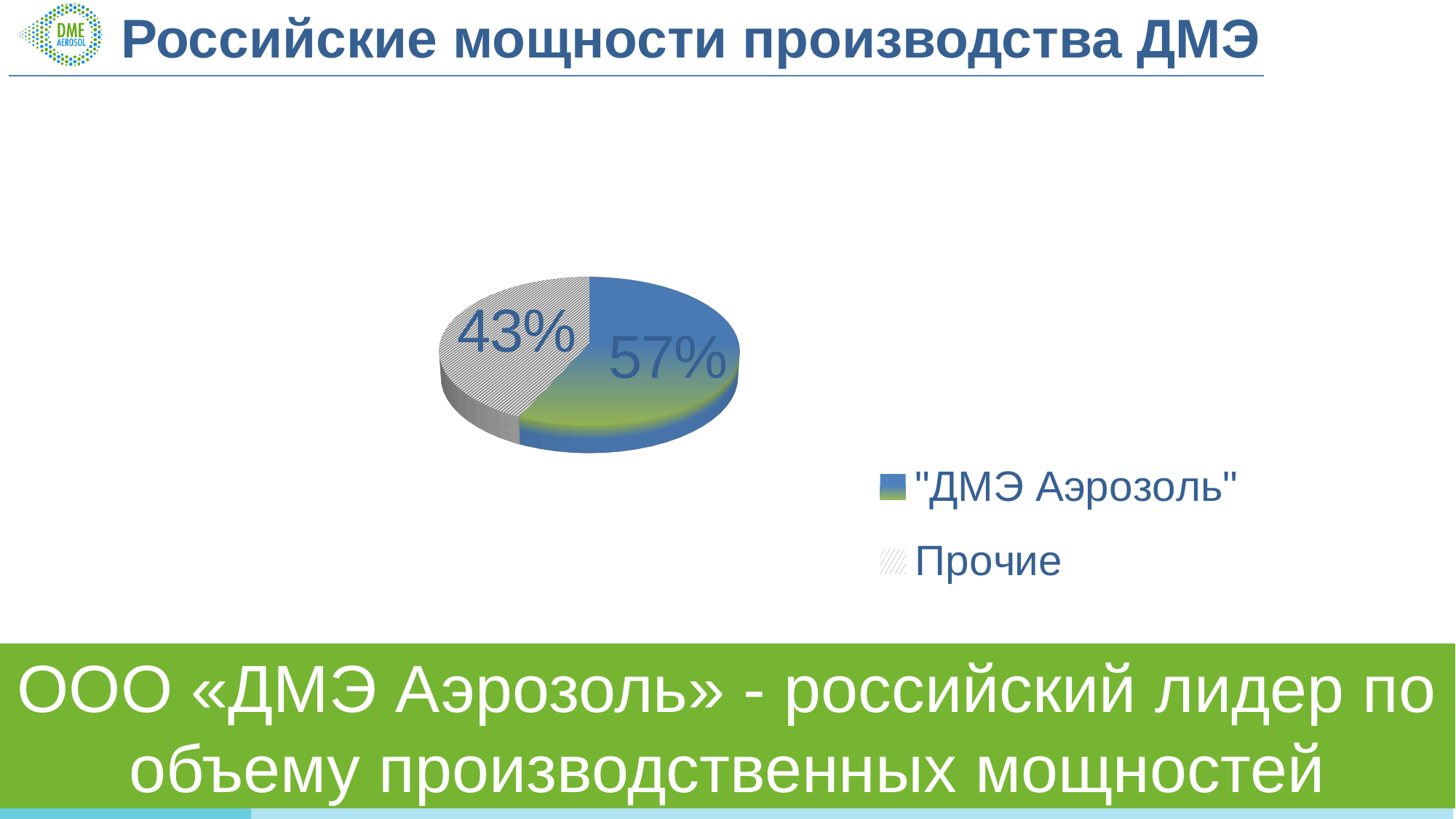
Which slice of the pie is the largest? "ДМЭ Аэрозоль" Which legend entry is shown with a hatched (striped) pattern? Прочие How many slices does the pie chart have? 2 How many entries does the legend list? 2 Which slice of the pie is the smallest? Прочие What is the title of the slide containing the pie chart? Российские мощности производства ДМЭ What kind of chart is shown on the slide? pie chart What share of the pie does Прочие hold? 43% Is the share for "ДМЭ Аэрозоль" greater or less than 50%? greater Which is larger: the share for "ДМЭ Аэрозоль" or the share for Прочие? "ДМЭ Аэрозоль" What share of the pie does "ДМЭ Аэрозоль" hold? 57% What is the difference in percentage points between the "ДМЭ Аэрозоль" slice and the Прочие slice? 14%